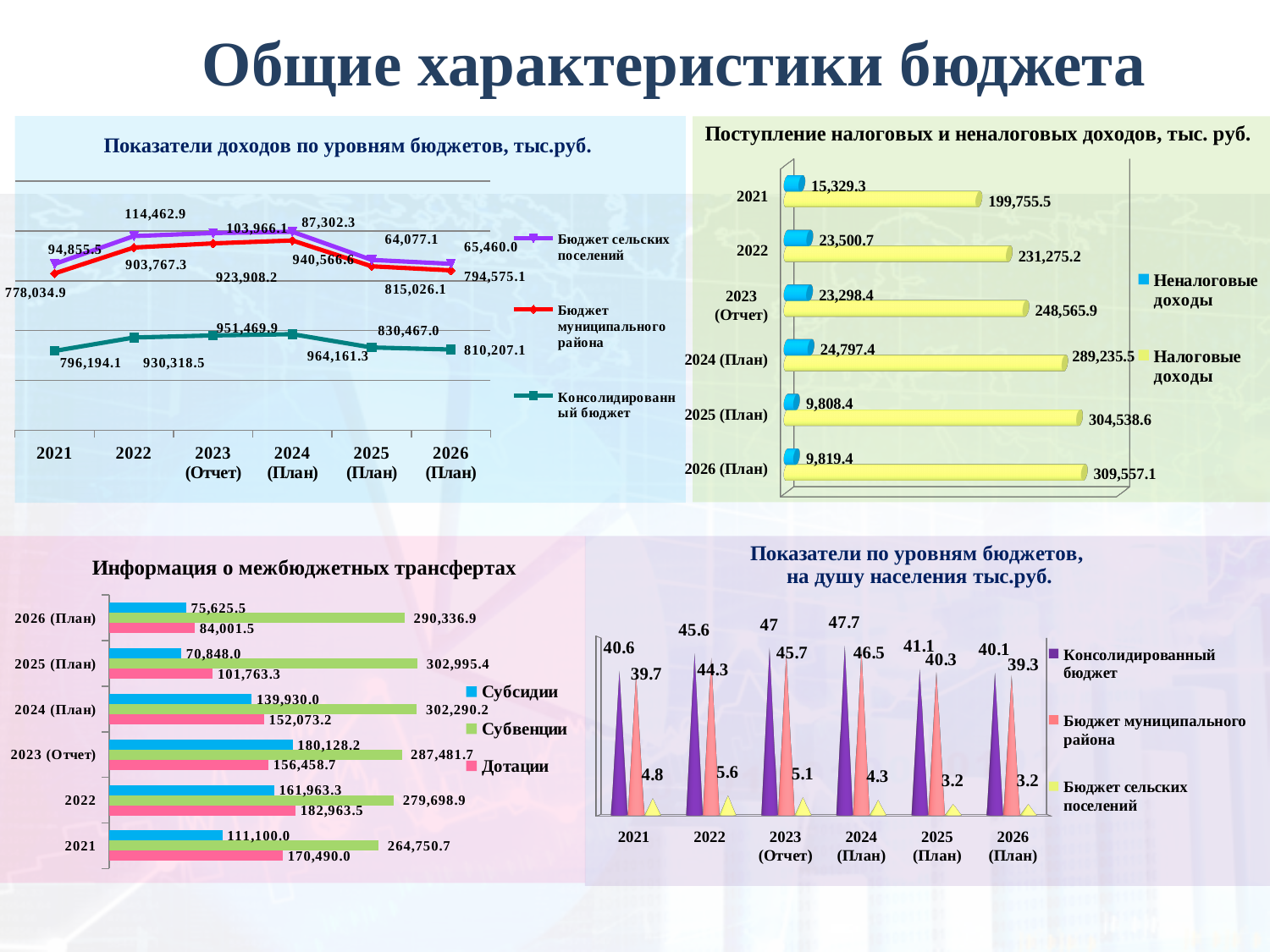
In the chart 'Показатели по уровням бюджетов, на душу населения тыс.руб.', what is the value of Консолидированный бюджет for 2024 (План)? 47.7 In the chart 'Показатели доходов по уровням бюджетов, тыс.руб.', what is the value of Бюджет сельских поселений for 2022? 114,462.9 In the chart 'Информация о межбюджетных трансфертах', how many series does the legend list? 3 In the chart 'Поступление налоговых и неналоговых доходов, тыс. руб.', do the Налоговые доходы values rise or fall from 2021 to 2026 (План)? rise In the chart 'Поступление налоговых и неналоговых доходов, тыс. руб.', what is the value of Налоговые доходы for 2026 (План)? 309,557.1 In the chart 'Показатели по уровням бюджетов, на душу населения тыс.руб.', which year has the highest value of Бюджет сельских поселений? 2022 In the chart 'Поступление налоговых и неналоговых доходов, тыс. руб.', which year has the highest value of Неналоговые доходы? 2024 (План) In the chart 'Информация о межбюджетных трансфертах', what is the value of Субвенции for 2025 (План)? 302,995.4 In the chart 'Информация о межбюджетных трансфертах', which is larger for 2022: Субсидии or Дотации? Дотации In the chart 'Поступление налоговых и неналоговых доходов, тыс. руб.', what is the difference between Налоговые доходы in 2022 and 2021? 31,519.7 How many charts are shown on the slide? 4 In the chart 'Информация о межбюджетных трансфертах', which year has the lowest value of Субсидии? 2025 (План)